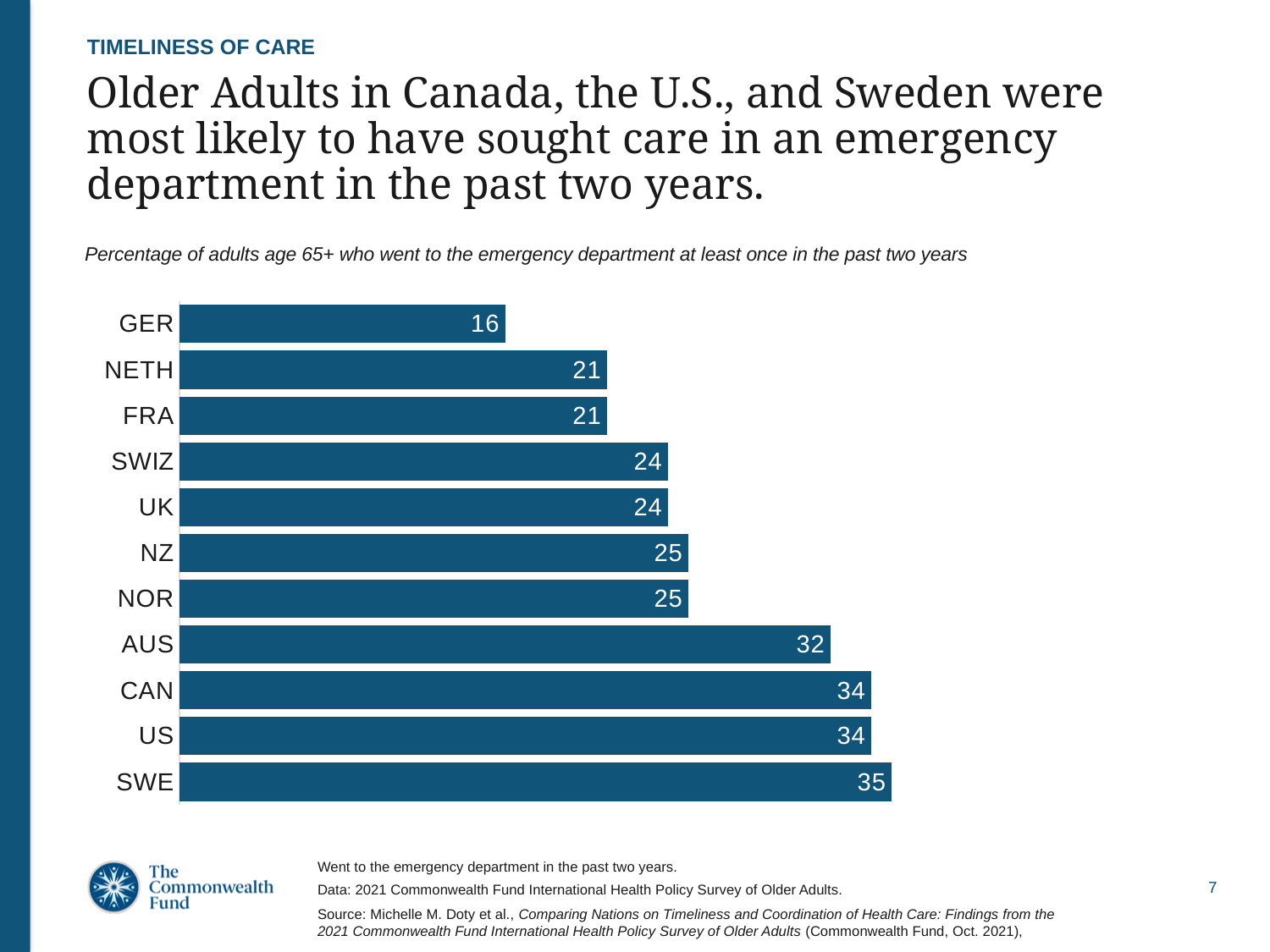
What is the value for SWIZ? 24 What is the difference between the values for CAN and AUS? 2 What is the difference between the values for SWE and GER? 19 How many countries are shown in the chart? 11 What is the value for AUS? 32 Which country has the lowest value? GER What kind of chart is shown on the slide? bar chart Do the values rise or fall going from the top bar (GER) to the bottom bar (SWE)? rise Which is larger, the value for NOR or the value for NETH? NOR What is the value for GER? 16 Which country has the highest value? SWE What is the value for US? 34